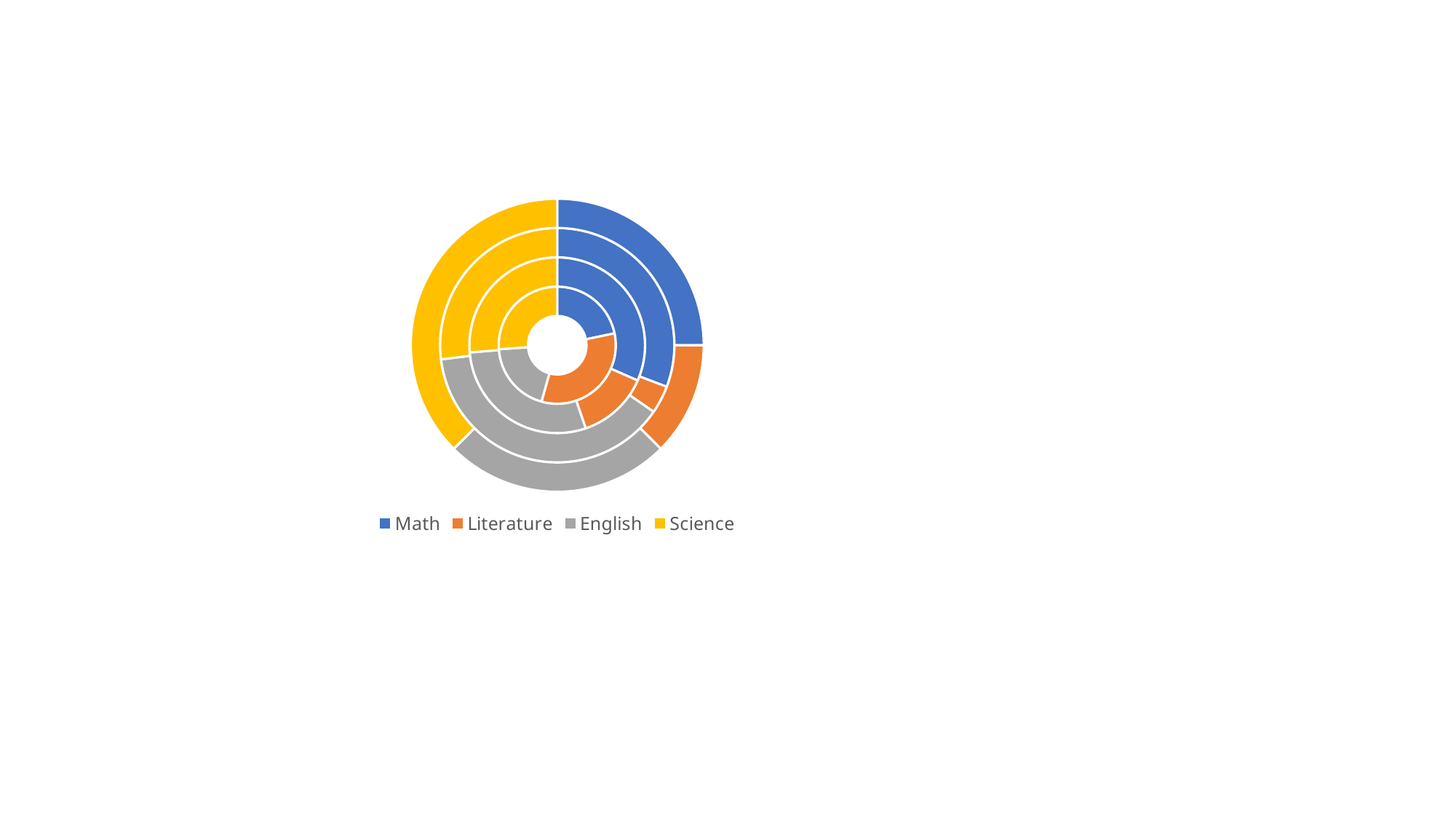
In the outermost ring, which slice is larger, Math or Literature? Math In the outermost ring, which category has the largest slice? Science Which categories are listed in the legend? Math, Literature, English, Science What kind of chart is shown on the slide? Doughnut chart How many concentric rings does the doughnut chart have? 4 In the innermost ring, which slice is larger, English or Science? Science In the innermost ring, which category has the largest slice? Literature In the outermost ring, which category has the smallest slice? Literature How many entries does the legend list? 4 What colour represents Science in the chart? Yellow